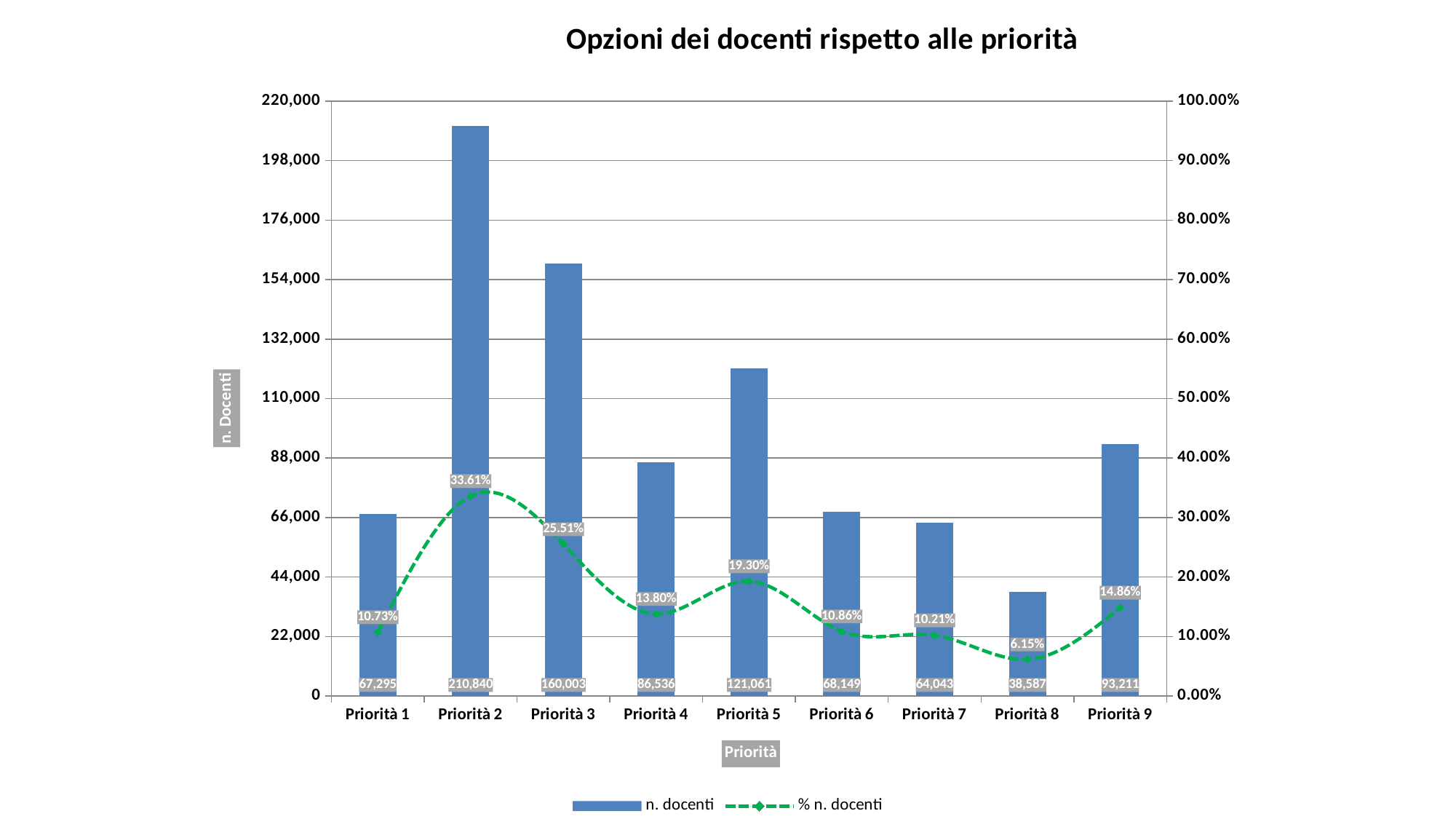
Which has a larger n. docenti, Priorità 1 or Priorità 9? Priorità 9 What kind of chart is used for the n. docenti series? bar chart How many priority categories are shown on the x axis? 9 What is the title of the chart? Opzioni dei docenti rispetto alle priorità What is the value of n. docenti for Priorità 2? 210,840 What is the % n. docenti value for Priorità 5? 19.30% What is the difference in n. docenti between Priorità 3 and Priorità 4? 73,467 Is the n. docenti value for Priorità 5 greater or less than 110,000? greater Which priority has the lowest % n. docenti? Priorità 8 How many series does the legend list? 2 What is the value of n. docenti for Priorità 8? 38,587 Which priority has the highest n. docenti? Priorità 2